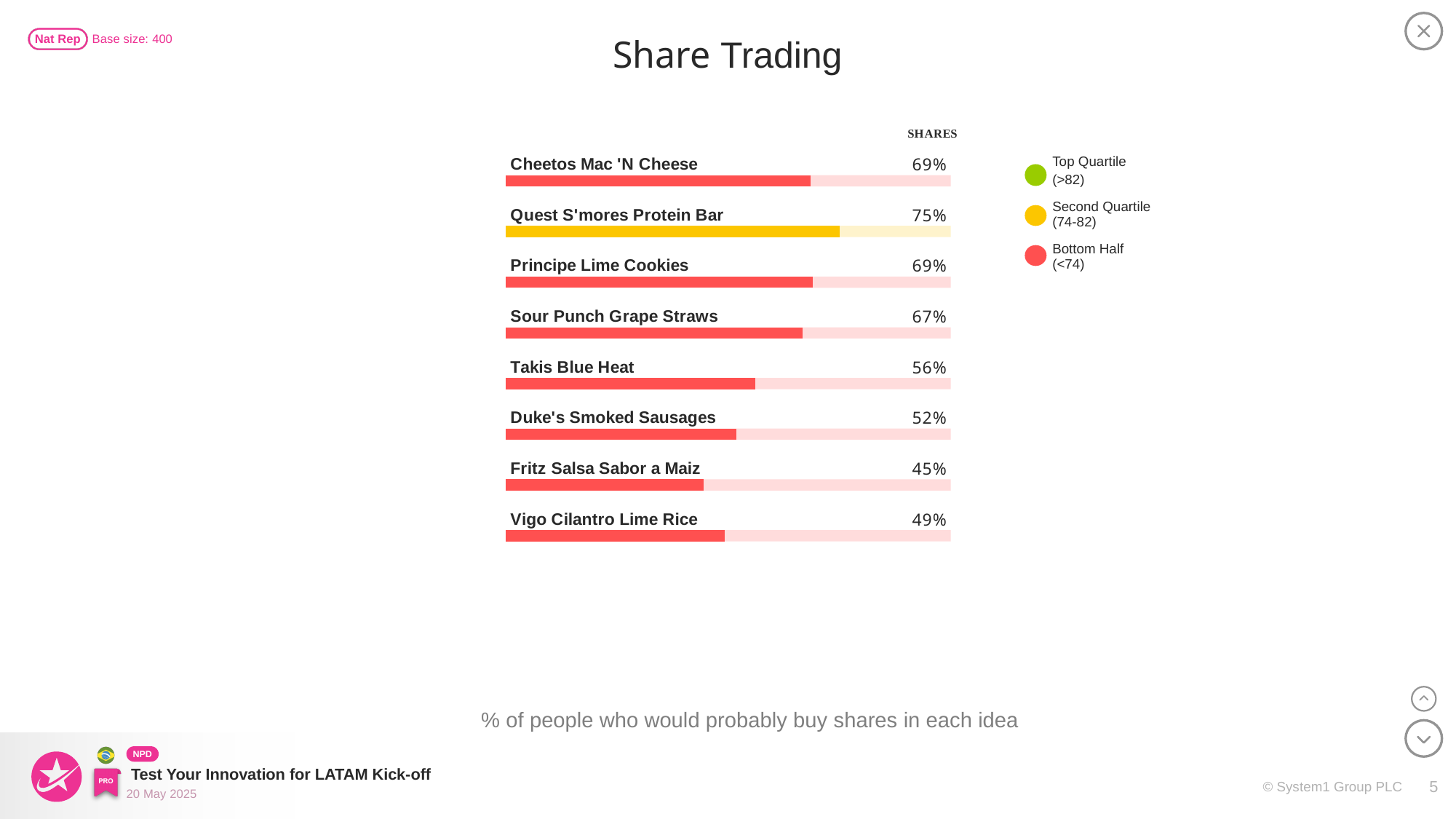
Which idea's bar is coloured yellow (Second Quartile)? Quest S'mores Protein Bar What is the difference between the Shares values for Sour Punch Grape Straws and Fritz Salsa Sabor a Maiz? 22% Which idea has the lowest Shares value? Fritz Salsa Sabor a Maiz What is the Shares value for Takis Blue Heat? 56% What is the difference between the Shares values for Quest S'mores Protein Bar and Duke's Smoked Sausages? 23% What is the base size shown on the slide? 400 Which has a higher Shares value, Takis Blue Heat or Vigo Cilantro Lime Rice? Takis Blue Heat How many ideas are shown in the chart? 8 Which idea has the highest Shares value? Quest S'mores Protein Bar What kind of chart is shown on the slide? Bar chart What is the Shares value for Vigo Cilantro Lime Rice? 49% What is the Shares value for Quest S'mores Protein Bar? 75%